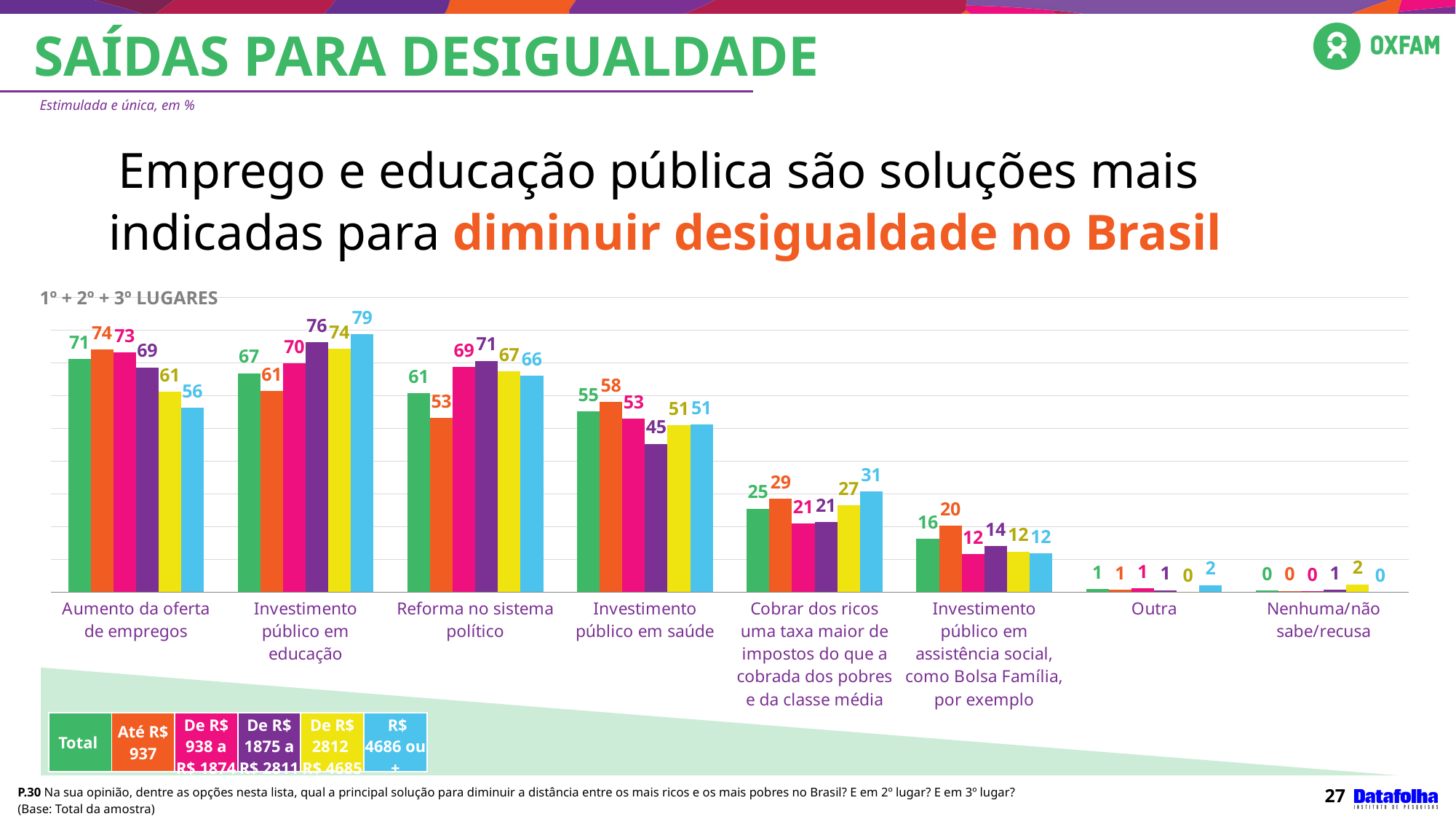
In the "Cobrar dos ricos uma taxa maior de impostos" category, which is larger: the value for "Até R$ 937" or the value for "R$ 4686 ou +"? R$ 4686 ou + What is the difference between the Total values for "Investimento público em educação" and "Investimento público em saúde"? 12 Do the Total values rise or fall from "Investimento público em educação" to "Nenhuma/não sabe/recusa" along the x axis? Fall What is the value for "Até R$ 937" in the "Reforma no sistema político" category? 53 How many categories are shown on the x axis of the chart? 8 What is the Total value for "Aumento da oferta de empregos"? 71 What is the value for "R$ 4686 ou +" in the "Investimento público em educação" category? 79 How many series does the legend list? 6 Which category has the highest Total value? Aumento da oferta de empregos What is the label shown above the chart, just below the headline? 1º + 2º + 3º LUGARES Within the "Investimento público em saúde" category, which series has the lowest value? De R$ 1875 a R$ 2811 What kind of chart is shown on the slide? Bar chart